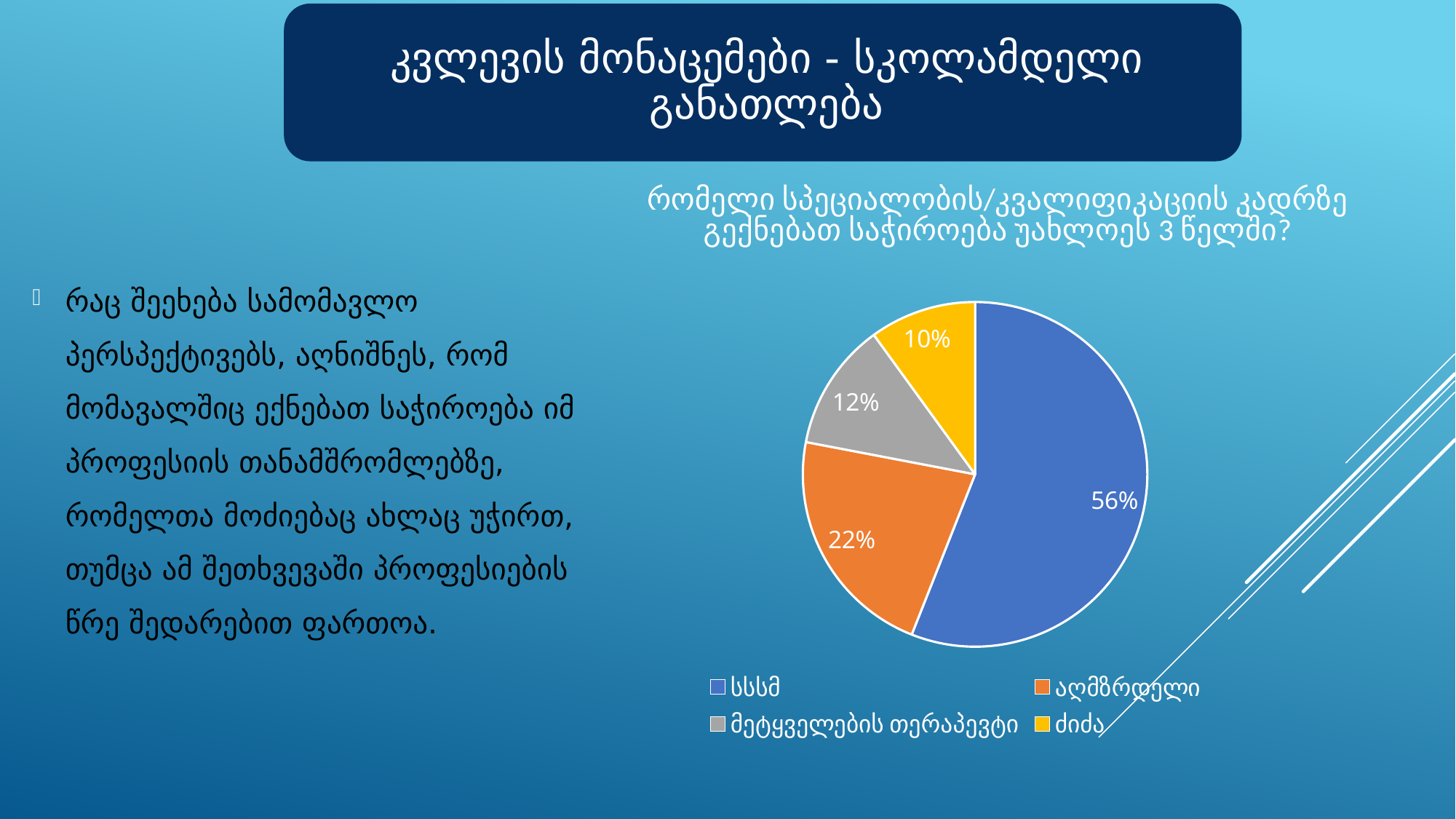
How many categories does the pie chart have? 4 What type of chart is shown on the slide? pie chart What is the title of the pie chart? რომელი სპეციალობის/კვალიფიკაციის კადრზე გექნებათ საჭიროება უახლოეს 3 წელში? Which is larger, the share for აღმზრდელი or the share for მეტყველების თერაპევტი? აღმზრდელი Which category has the largest slice of the pie? სსსმ What is the difference between the shares of სსსმ and აღმზრდელი? 34% What colour is the slice for ძიძა? yellow What share of the pie does სსსმ represent? 56% What is the value shown for ძიძა? 10% What is the value shown for აღმზრდელი? 22% Which category has the smallest slice of the pie? ძიძა What is the value shown for მეტყველების თერაპევტი? 12%